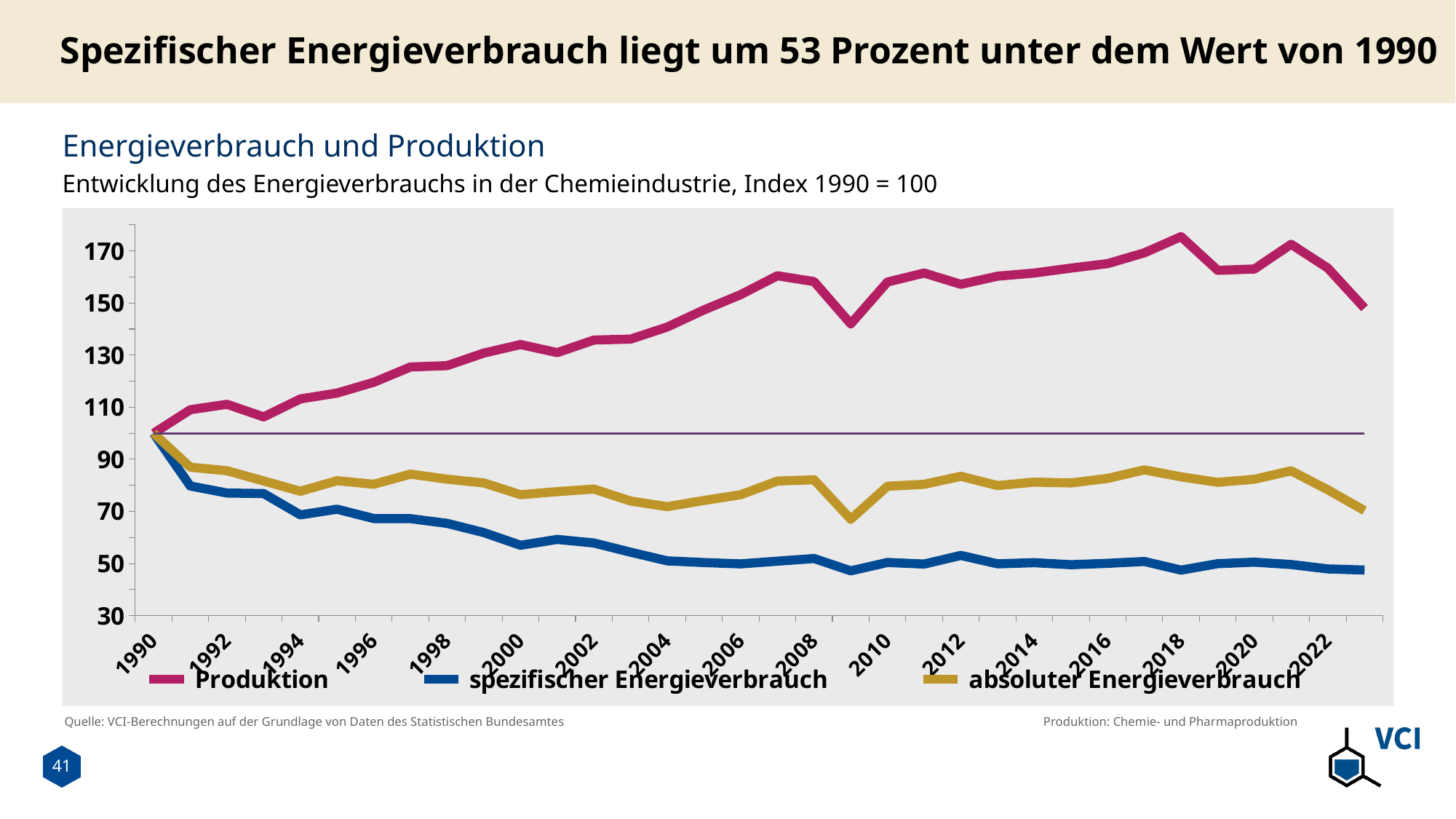
Which series has the highest value in 2022? Produktion Is the value for Produktion in 2018 greater or less than 170? greater Does the spezifischer Energieverbrauch series generally rise or fall from 1990 to 2022? fall What kind of chart is shown on the slide? line chart Is the value for Produktion in 2009 greater or less than 150? less Does the Produktion series generally rise or fall from 1990 to 2022? rise How many series does the legend list? 3 What is the title of the chart? Energieverbrauch und Produktion In 2010, which is larger: absoluter Energieverbrauch or spezifischer Energieverbrauch? absoluter Energieverbrauch Is the value for spezifischer Energieverbrauch in 2000 greater or less than 70? less What is the index value of all three series in 1990? 100